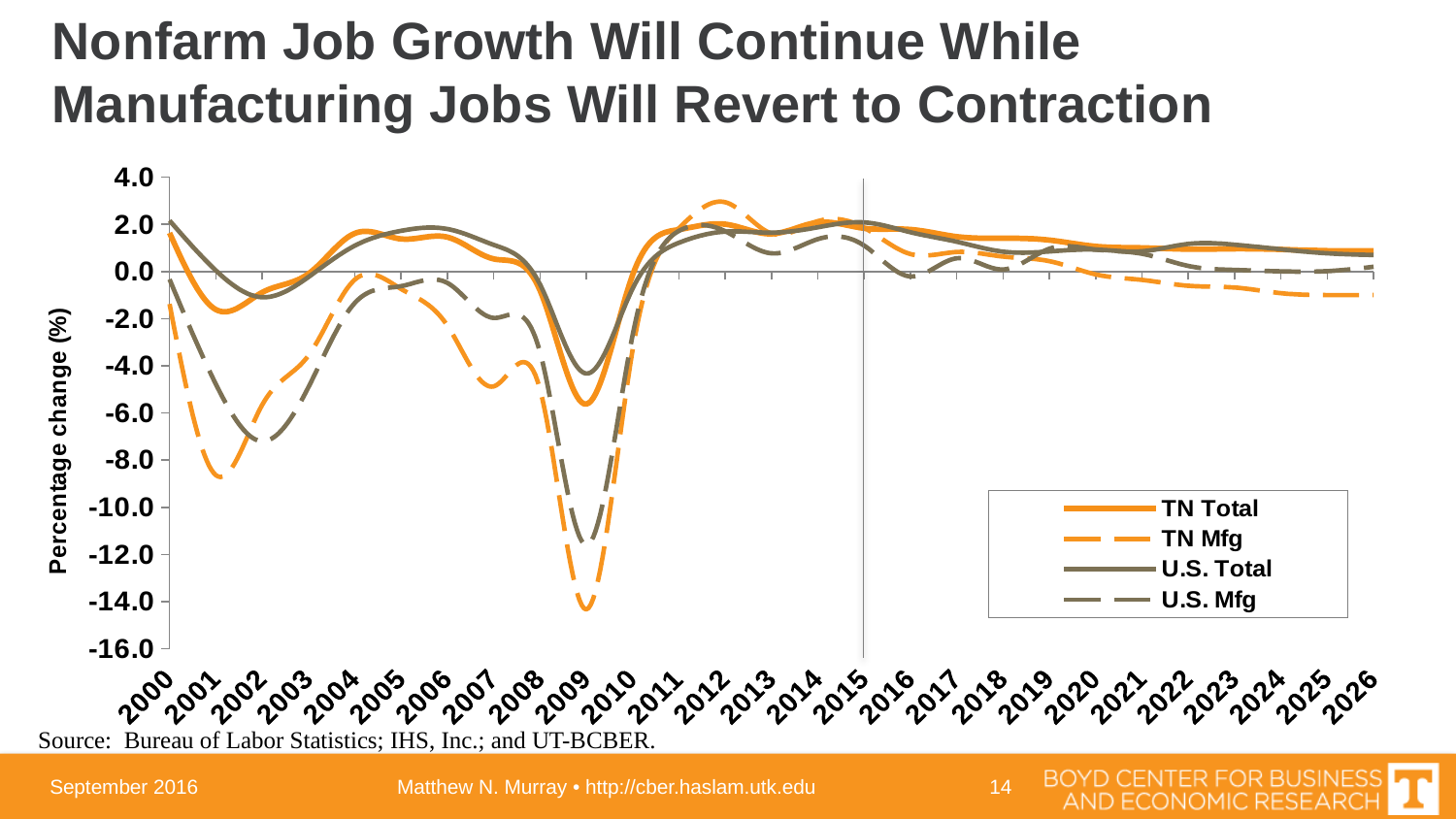
Is the value for TN Total in 2009 greater or less than -4.0? less What is the label on the y axis? Percentage change (%) Does the TN Mfg series rise or fall from 2016 to 2026? Fall How many series does the legend list? 4 What kind of chart is shown on the slide? Line chart In 2009, which series is lower: TN Mfg or U.S. Mfg? TN Mfg In which year does the TN Mfg series reach its lowest point? 2009 Which series reaches the lowest value on the chart? TN Mfg Is the value for U.S. Mfg in 2009 greater or less than -10.0? less Is the value for TN Mfg in 2009 greater or less than -12.0? less How many years are labelled along the x axis? 27